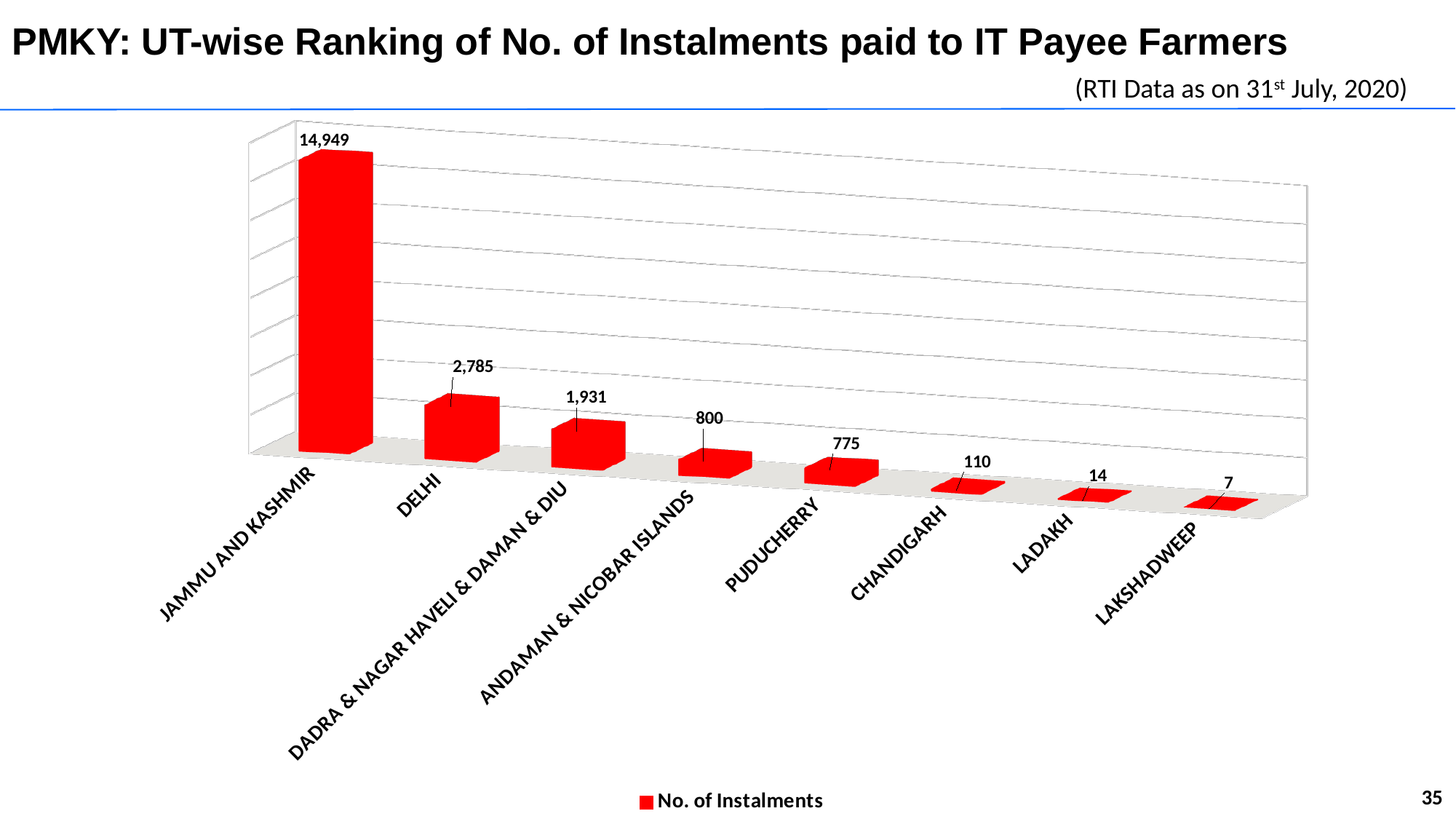
Which UT has the highest number of instalments? Jammu and Kashmir Which has more instalments, Dadra & Nagar Haveli & Daman & Diu or Chandigarh? Dadra & Nagar Haveli & Daman & Diu What is the difference in number of instalments between Andaman & Nicobar Islands and Puducherry? 25 What is the number of instalments for Delhi? 2,785 How many UTs are shown in the chart? 8 What is the number of instalments for Puducherry? 775 What is the difference in number of instalments between Jammu and Kashmir and Delhi? 12,164 What is the legend entry for the series shown? No. of Instalments How many series does the legend list? 1 What kind of chart is shown on the slide? Bar chart Which UT has the lowest number of instalments? Lakshadweep What is the number of instalments for Ladakh? 14